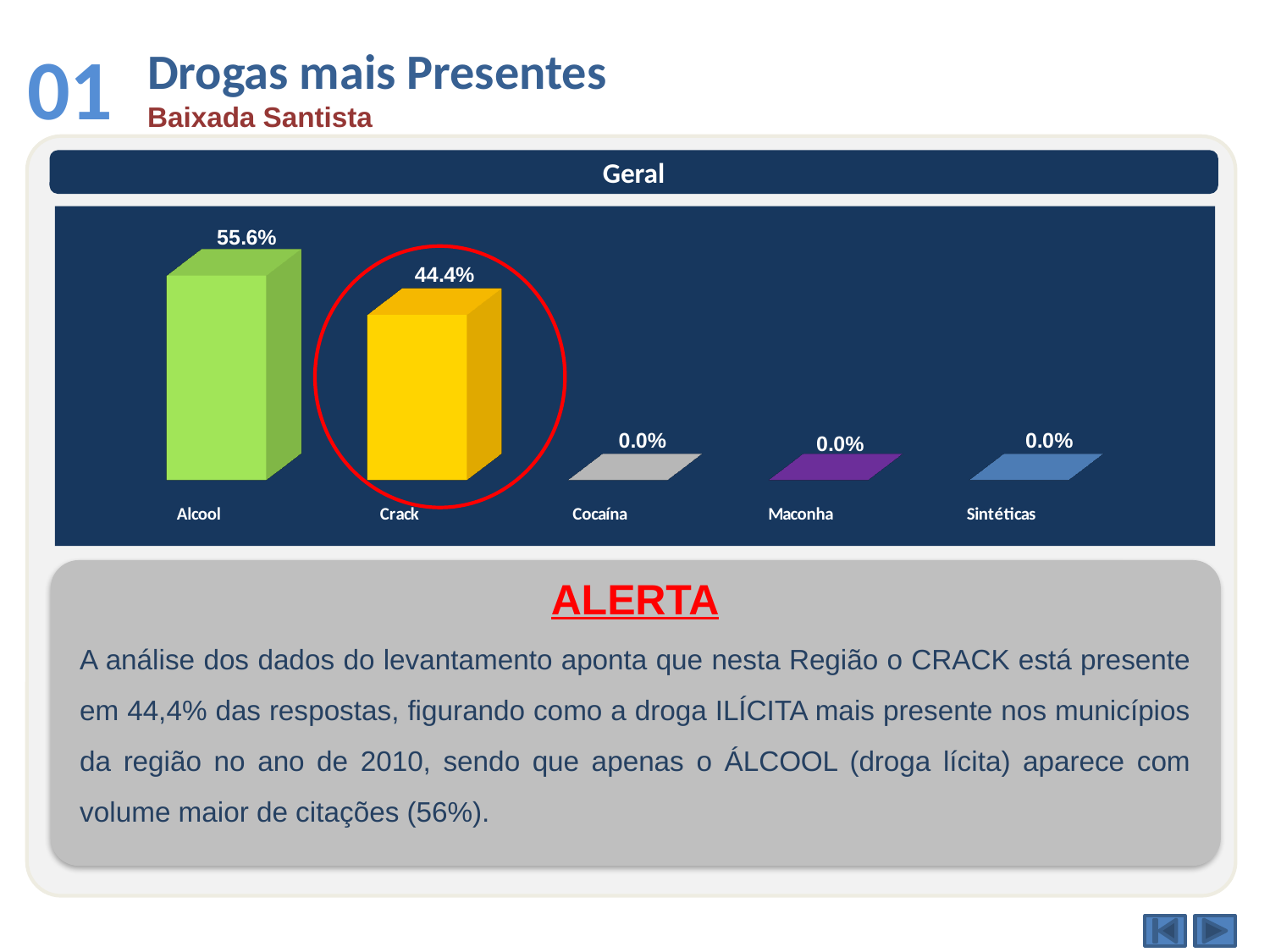
What is the value for Alcool? 55.6% Which is larger, the value for Crack or the value for Sintéticas? Crack How many categories have a value of 0.0%? 3 What is the value for Cocaína? 0.0% What is the title shown above the chart? Geral Which bar is circled in red on the chart? Crack What is the value for Maconha? 0.0% How many categories are shown in the chart? 5 What is the difference between the values for Alcool and Crack? 11.2% What kind of chart is shown on the slide? Bar chart What is the value for Crack? 44.4% Which category has the highest value? Alcool